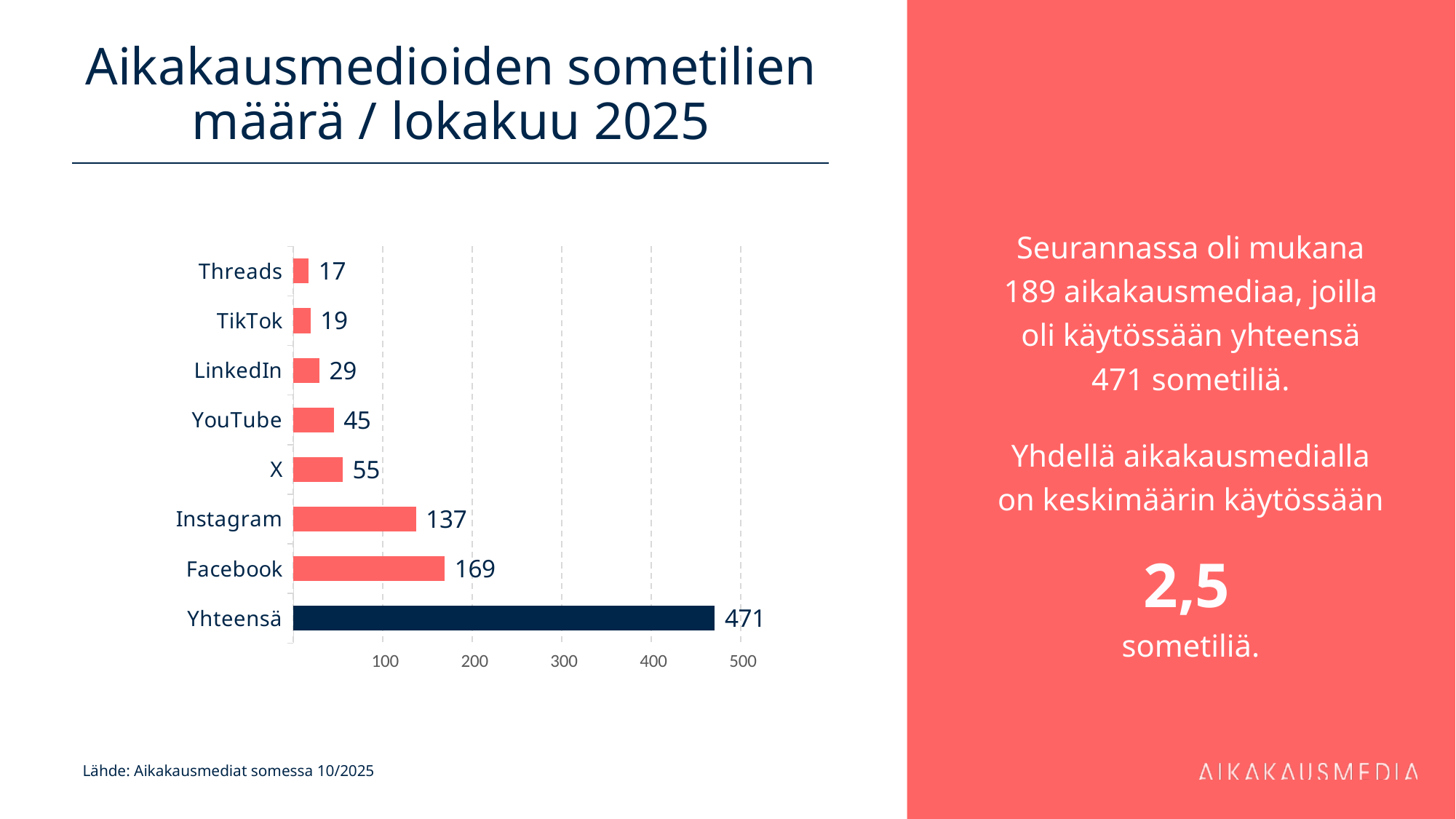
What is the value for Facebook? 169 Which platform has the lowest value? Threads What is the value shown for Yhteensä? 471 How many bars are shown in the chart, including the Yhteensä total bar? 8 What is the value for Instagram? 137 What is the value for Threads? 17 Is the value for Instagram greater or less than 100? greater What is the title of the slide? Aikakausmedioiden sometilien määrä / lokakuu 2025 What kind of chart is shown on the slide? Bar chart Which is larger, the value for X or the value for YouTube? X What is the difference between the values for Facebook and Instagram? 32 Excluding the Yhteensä total bar, which platform has the highest value? Facebook